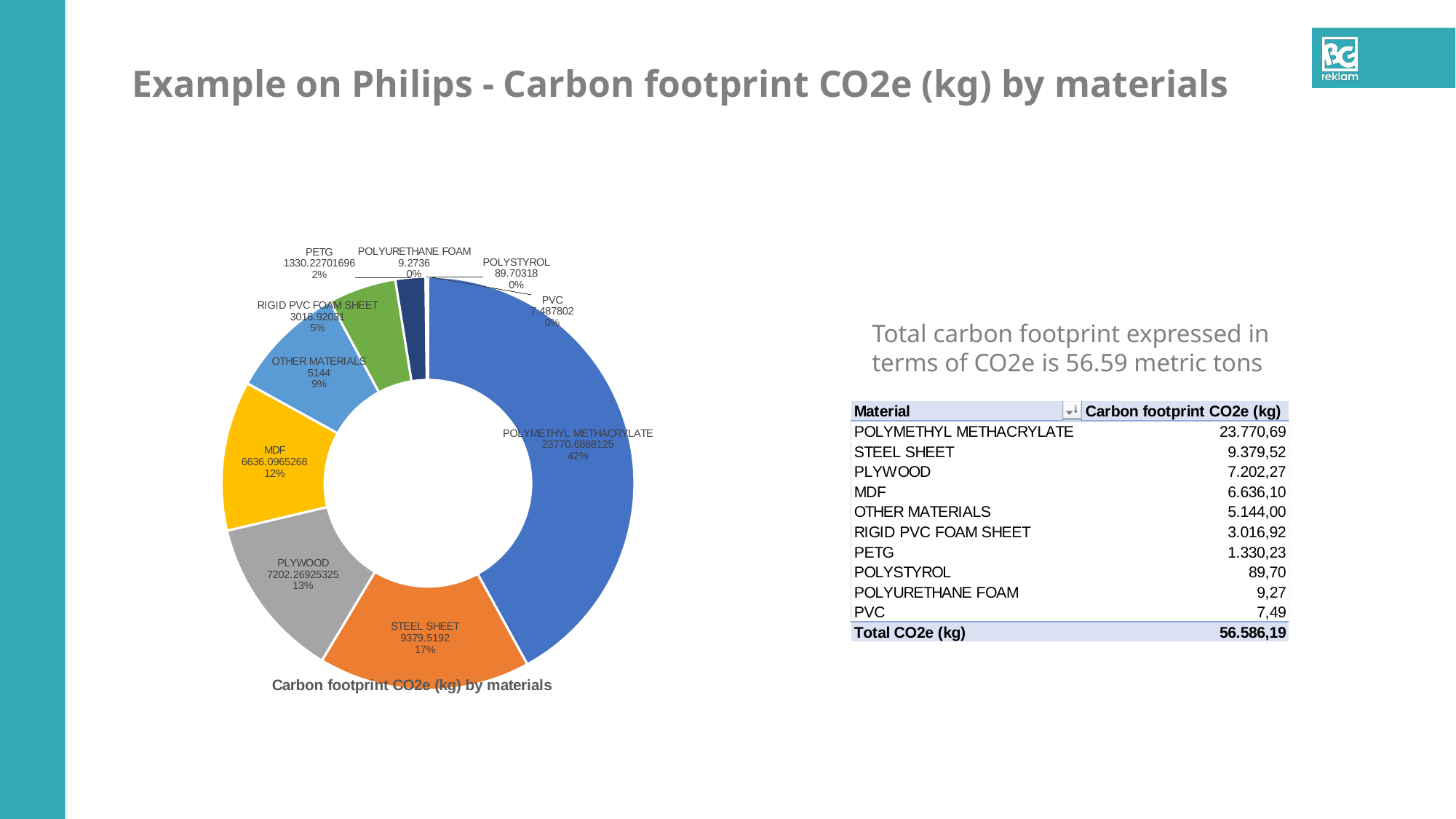
What is the carbon footprint value labelled for OTHER MATERIALS in the chart? 5144 Which material has the smallest carbon footprint value in the chart? PVC Which material has the largest share of the carbon footprint in the chart? POLYMETHYL METHACRYLATE What kind of chart is shown on the slide? Doughnut (pie) chart What is the carbon footprint value labelled for STEEL SHEET in the chart? 9379.5192 What is the difference in percentage share between POLYMETHYL METHACRYLATE and STEEL SHEET in the chart? 25 percentage points What percentage share does MDF have in the chart? 12% What is the carbon footprint value labelled for POLYSTYROL in the chart? 89.70318 How many material categories are shown in the chart? 10 Which has a larger carbon footprint in the chart, PLYWOOD or MDF? PLYWOOD What is the title of the chart? Carbon footprint CO2e (kg) by materials What percentage share does POLYMETHYL METHACRYLATE have in the chart? 42%